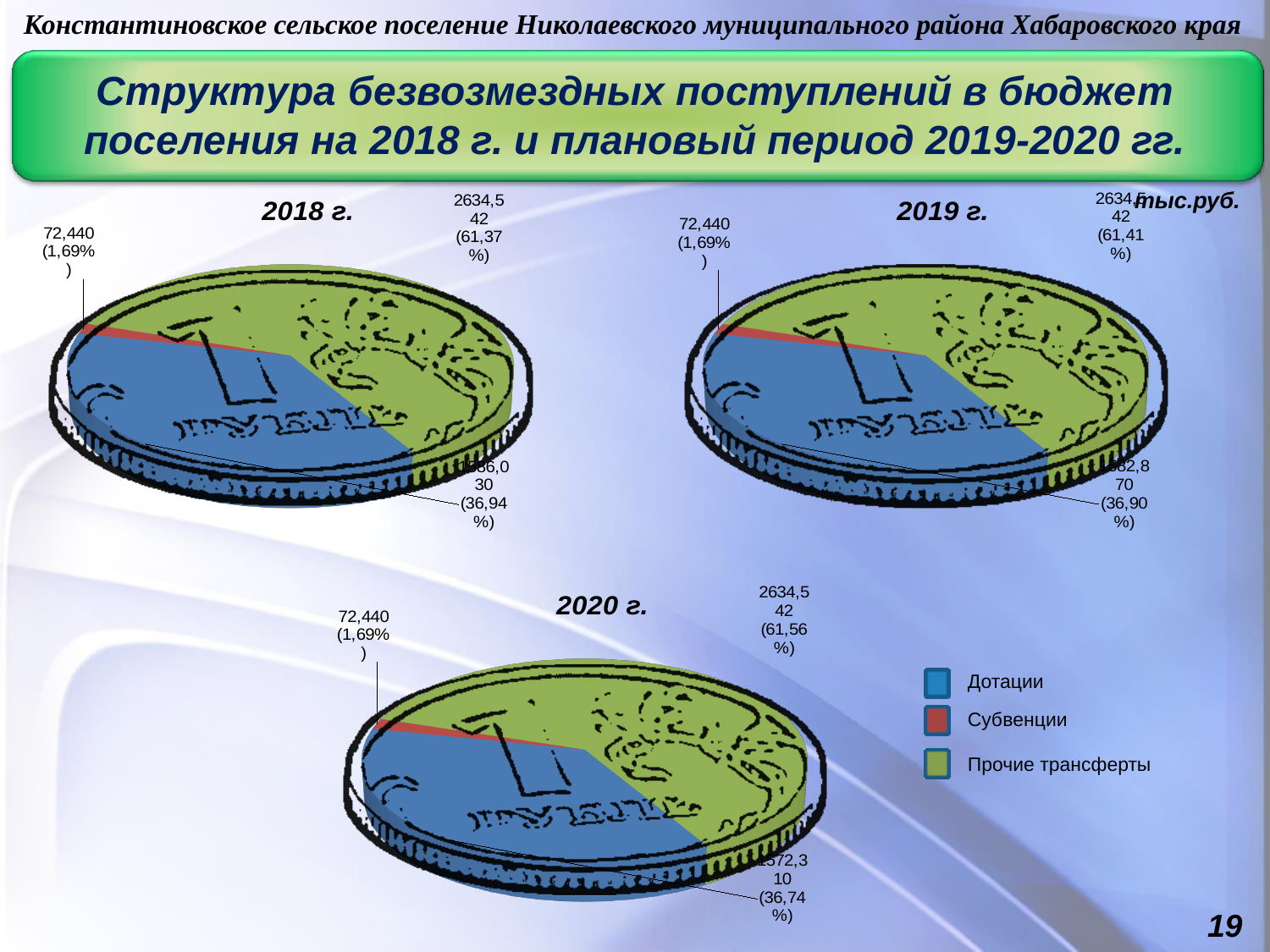
In the 2020 г. chart, which category has the smallest slice? Субвенции In the 2019 г. chart, what share is shown for Дотации? 36,90% In the 2019 г. chart, what share is shown for Прочие трансферты? 61,41% In the 2018 г. chart, which category has the largest slice? Прочие трансферты In the 2018 г. chart, what share is shown for Прочие трансферты? 61,37% In the 2020 г. chart, what share is shown for Прочие трансферты? 61,56% In the 2018 г. chart, what value is shown for Субвенции? 72,440 What kind of chart is used for the 2018 г. data on the slide? pie chart In the 2019 г. chart, which is larger: Дотации or Прочие трансферты? Прочие трансферты How many categories does the legend list? 3 How many pie charts are shown on the slide? 3 In the 2020 г. chart, what share is shown for Дотации? 36,74%